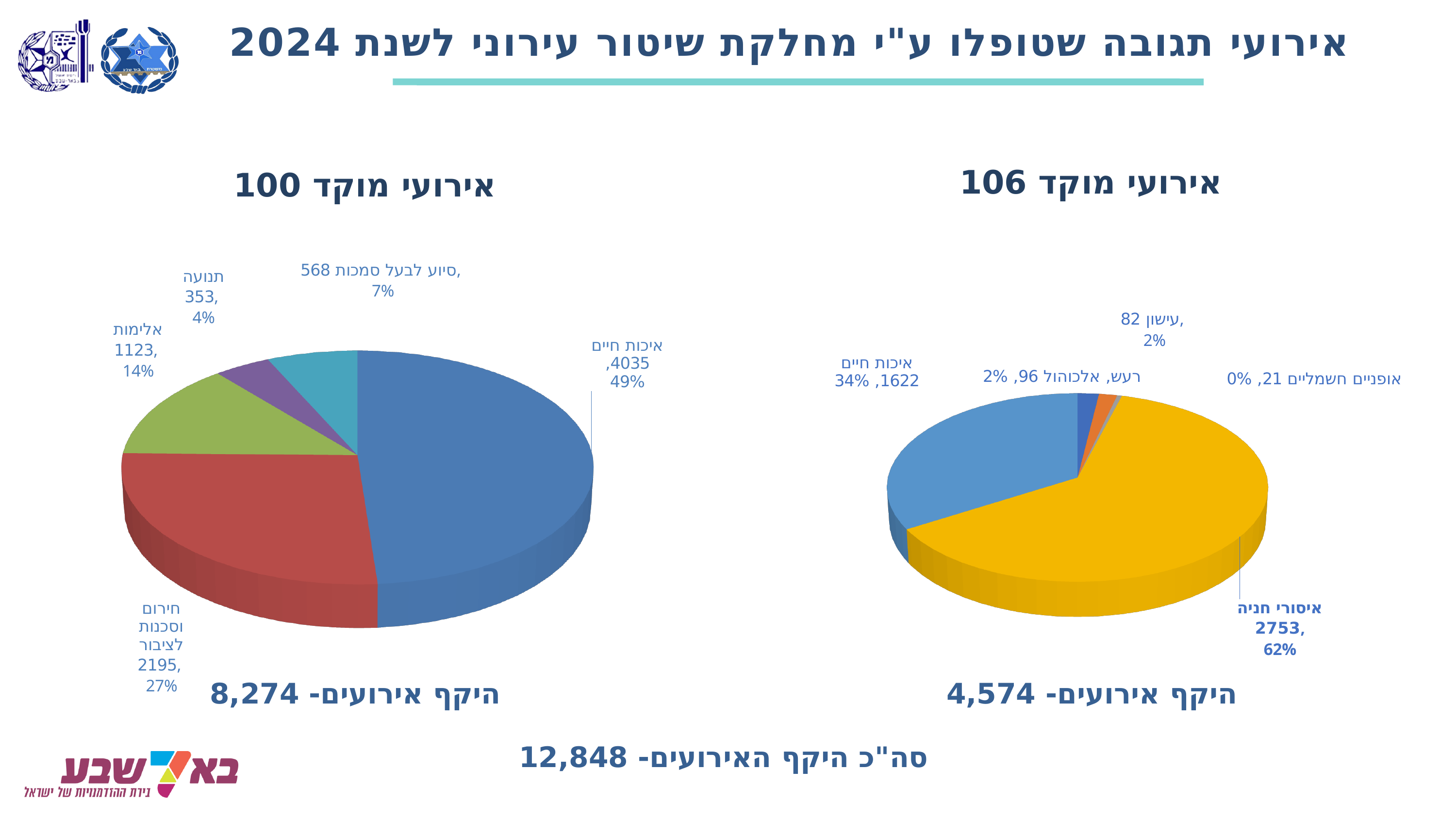
In the "אירועי מוקד 106" chart, what is the value for איסורי חניה? 2753 What type of chart is used for "אירועי מוקד 106"? Pie chart In the "אירועי מוקד 100" chart, what share of the pie does חירום וסכנות לציבור take? 27% What is the total number of events stated for the "אירועי מוקד 100" chart? 8,274 In the "אירועי מוקד 106" chart, what share of the pie does איכות חיים take? 34% In the "אירועי מוקד 100" chart, what is the difference between אלימות and סיוע לבעל סמכות? 555 In the "אירועי מוקד 106" chart, what is the difference between איסורי חניה and איכות חיים? 1131 How many slices does the "אירועי מוקד 100" pie chart have? 5 In the "אירועי מוקד 100" chart, what is the value for איכות חיים? 4035 In the "אירועי מוקד 106" chart, which category has the largest value? איסורי חניה In the "אירועי מוקד 106" chart, which is larger: עישון or אופניים חשמליים? עישון In the "אירועי מוקד 100" chart, which category has the smallest value? תנועה